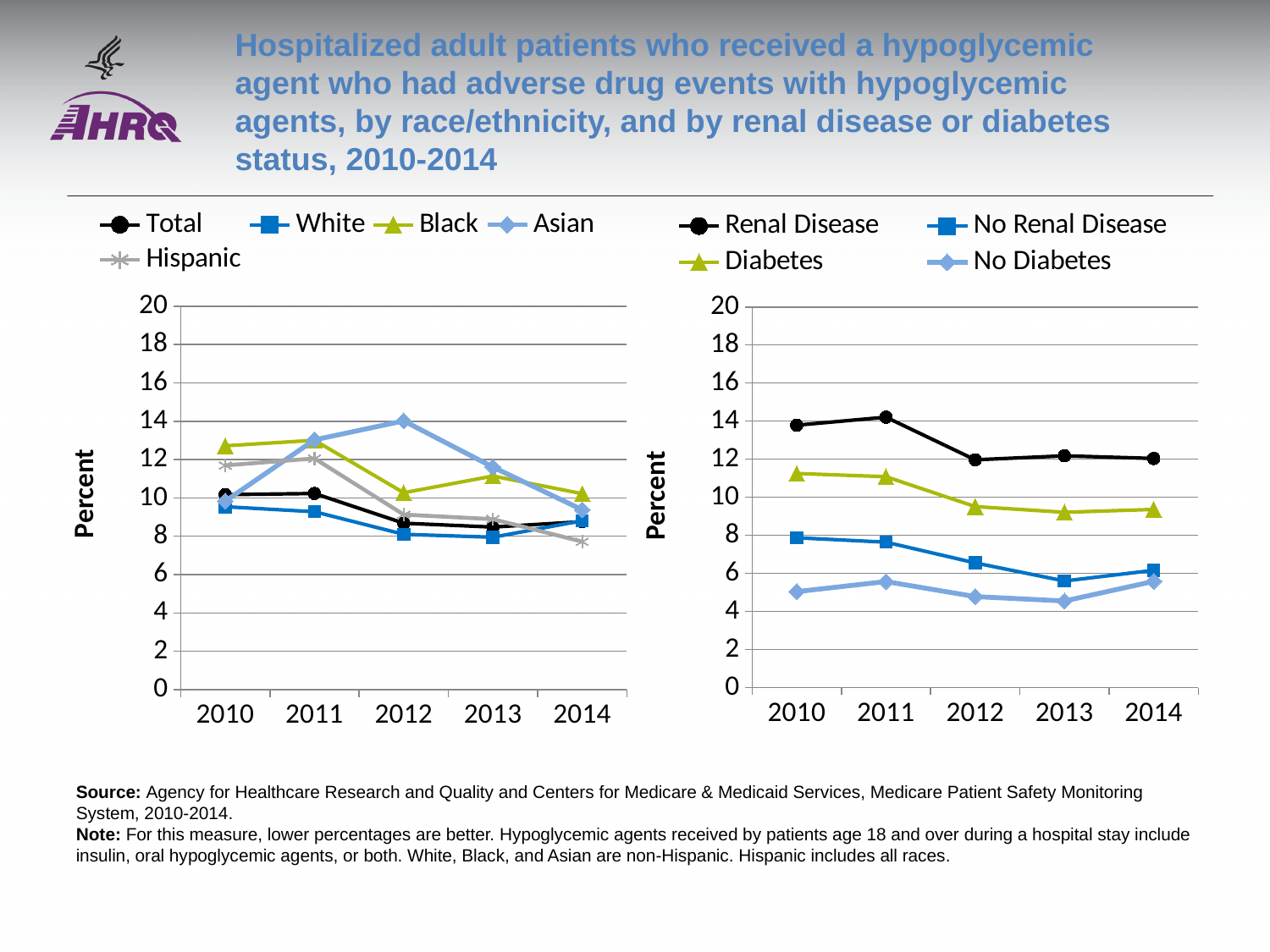
In the right chart (by renal disease or diabetes status), does the Diabetes series rise or fall overall from 2010 to 2014? Fall In the left chart (by race/ethnicity), which series has the highest value in 2012? Asian In the right chart (by renal disease or diabetes status), is the value for Renal Disease in 2010 greater or less than 12? greater In the right chart (by renal disease or diabetes status), is the value for No Diabetes in 2013 greater or less than 6? less In the left chart (by race/ethnicity), is the value for Asian in 2012 greater or less than 12? greater How many series does the legend of the left chart (by race/ethnicity) list? 5 How many series does the legend of the right chart (by renal disease or diabetes status) list? 4 How many years are shown on the x axis of the right chart (by renal disease or diabetes status)? 5 What kind of chart is the left chart (by race/ethnicity)? Line chart In the left chart (by race/ethnicity), which is larger in 2010, the value for Black or the value for White? Black In the right chart (by renal disease or diabetes status), which series has the highest value in 2011? Renal Disease In the right chart (by renal disease or diabetes status), which series has the lowest value in 2010? No Diabetes